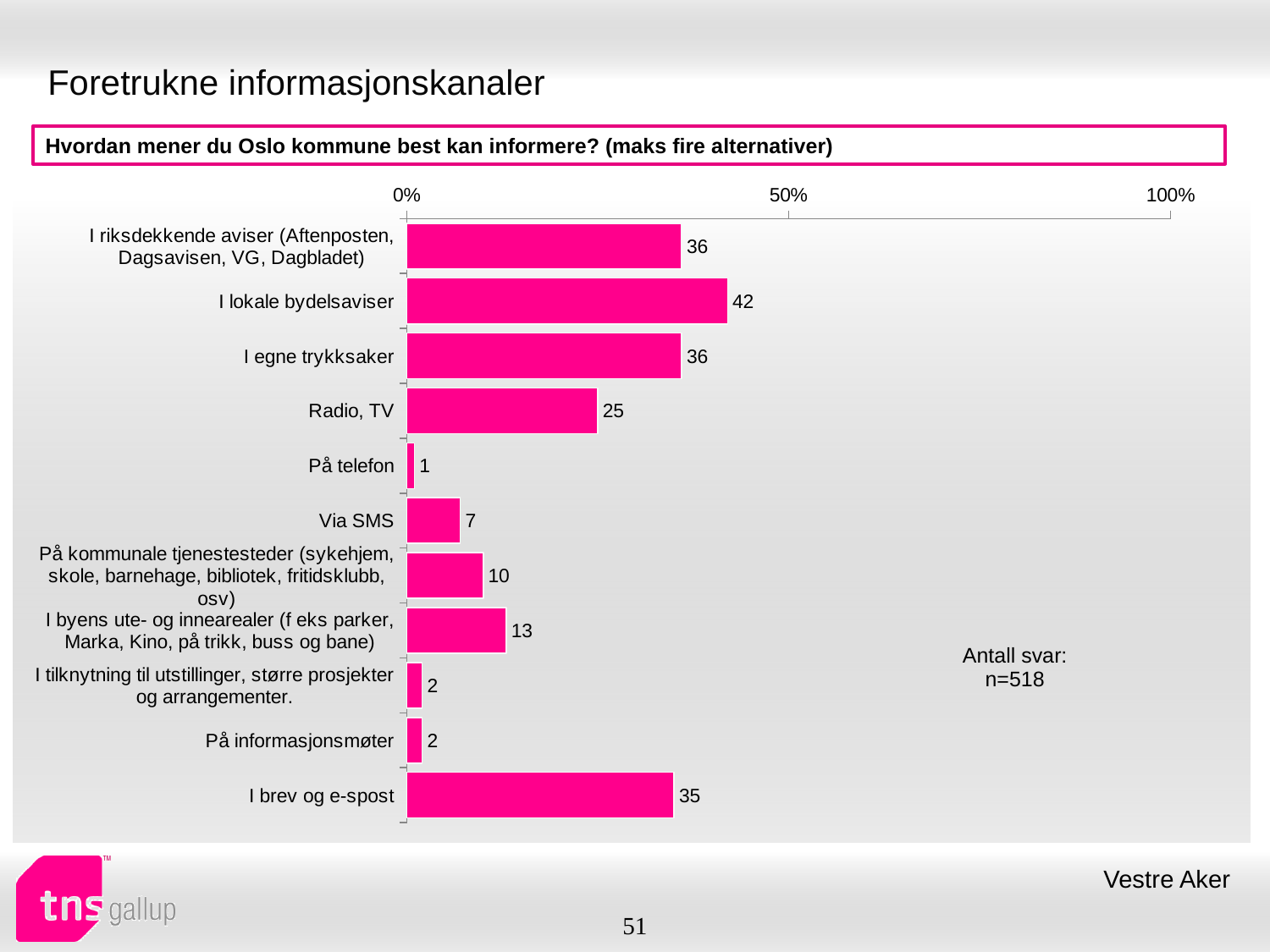
What is the value for 'I lokale bydelsaviser'? 42 What is the number of responses (n) stated on the slide? n=518 How many categories are shown in the chart? 11 What is the value for 'Via SMS'? 7 Which category has the lowest value? På telefon Which category has the highest value? I lokale bydelsaviser What is the value for 'I brev og e-spost'? 35 Is the value for 'I lokale bydelsaviser' greater or less than 50%? less What is the value for 'Radio, TV'? 25 What is the difference between the values for 'I lokale bydelsaviser' and 'I brev og e-spost'? 7 What kind of chart is shown on the slide? bar chart Which is larger: the value for 'Radio, TV' or the value for 'I egne trykksaker'? I egne trykksaker